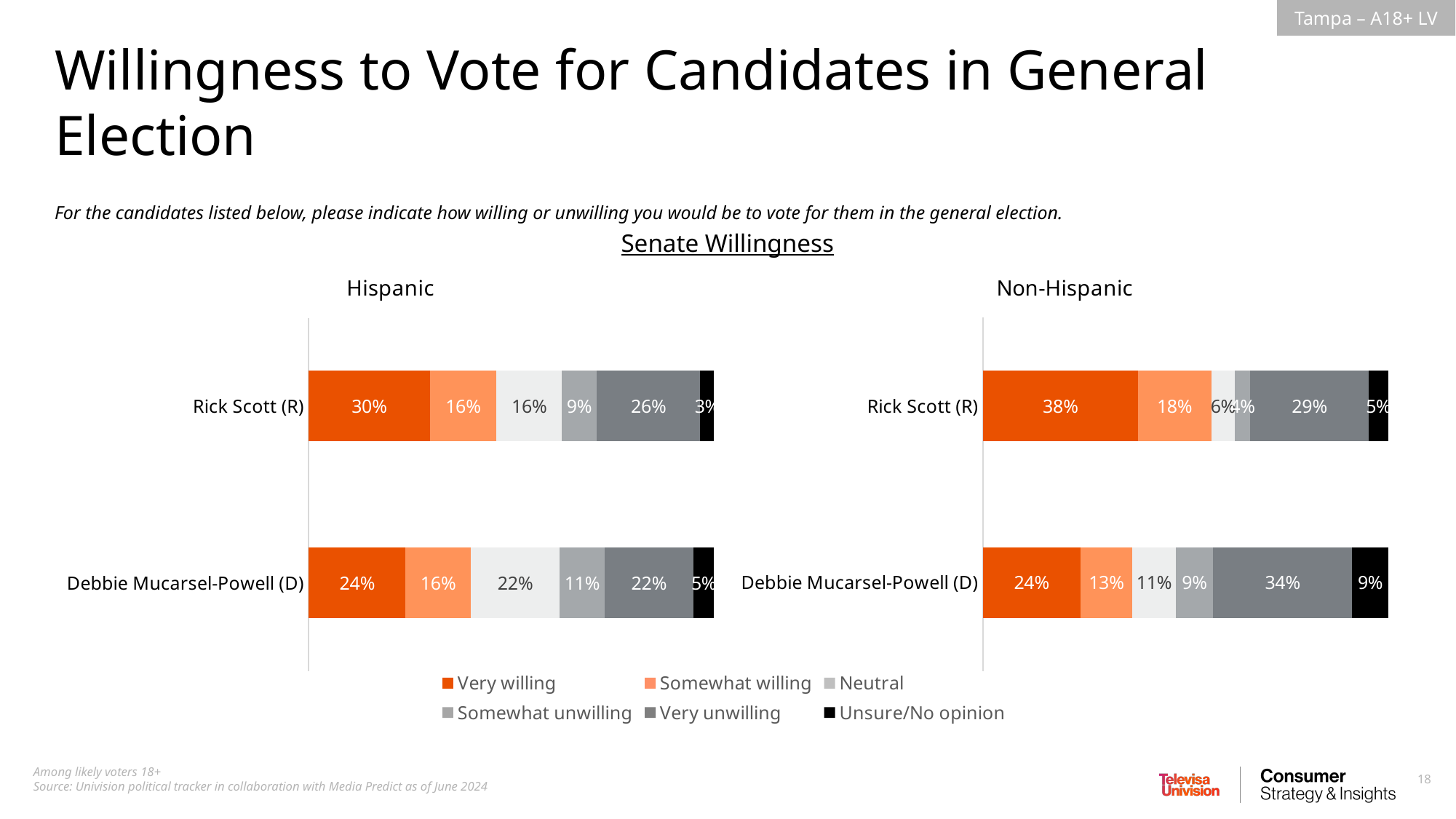
How many series does the legend list? 6 In the Hispanic chart, what percentage of respondents are very willing to vote for Rick Scott (R)? 30% In the Non-Hispanic chart, which candidate has the higher very willing percentage? Rick Scott (R) In the Non-Hispanic chart, what percentage of respondents are neutral on Rick Scott (R)? 6% How many candidates are shown in the Hispanic chart? 2 What kind of chart is used to show Senate Willingness? Stacked bar chart In the Hispanic chart, which candidate has the higher neutral percentage? Debbie Mucarsel-Powell (D) In the Hispanic chart, what is the difference between the very willing percentages for Rick Scott (R) and Debbie Mucarsel-Powell (D)? 6% In the Non-Hispanic chart, what is the difference between the very unwilling percentages for Debbie Mucarsel-Powell (D) and Rick Scott (R)? 5% Which colour represents the Unsure/No opinion segment in the legend? Black In the Hispanic chart, what percentage of respondents are unsure or have no opinion about Debbie Mucarsel-Powell (D)? 5% In the Non-Hispanic chart, what percentage of respondents are very unwilling to vote for Debbie Mucarsel-Powell (D)? 34%